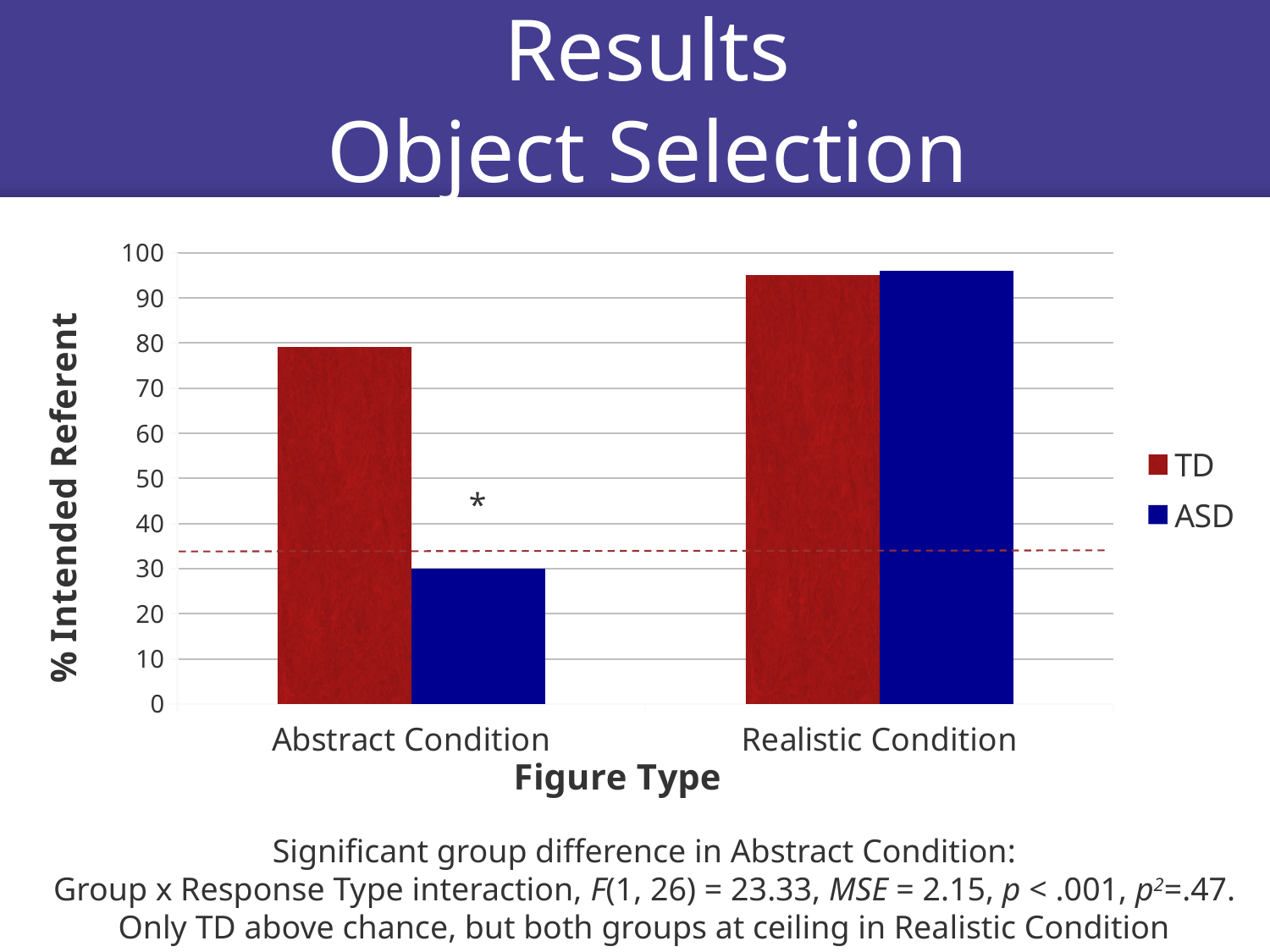
What kind of chart is shown on the slide? bar chart How many categories are shown on the x axis? 2 What is the title of the y axis? % Intended Referent Which bar is the lowest in the chart? ASD in the Abstract Condition Is the value for ASD in the Realistic Condition greater or less than 90? greater Does the ASD value rise or fall from the Abstract Condition to the Realistic Condition? rise In the Abstract Condition, which group has the higher bar, TD or ASD? TD Is the value for TD in the Realistic Condition greater or less than 90? greater How many series does the legend list? 2 Is the value for ASD in the Abstract Condition greater or less than 40? less What are the two series named in the legend? TD and ASD